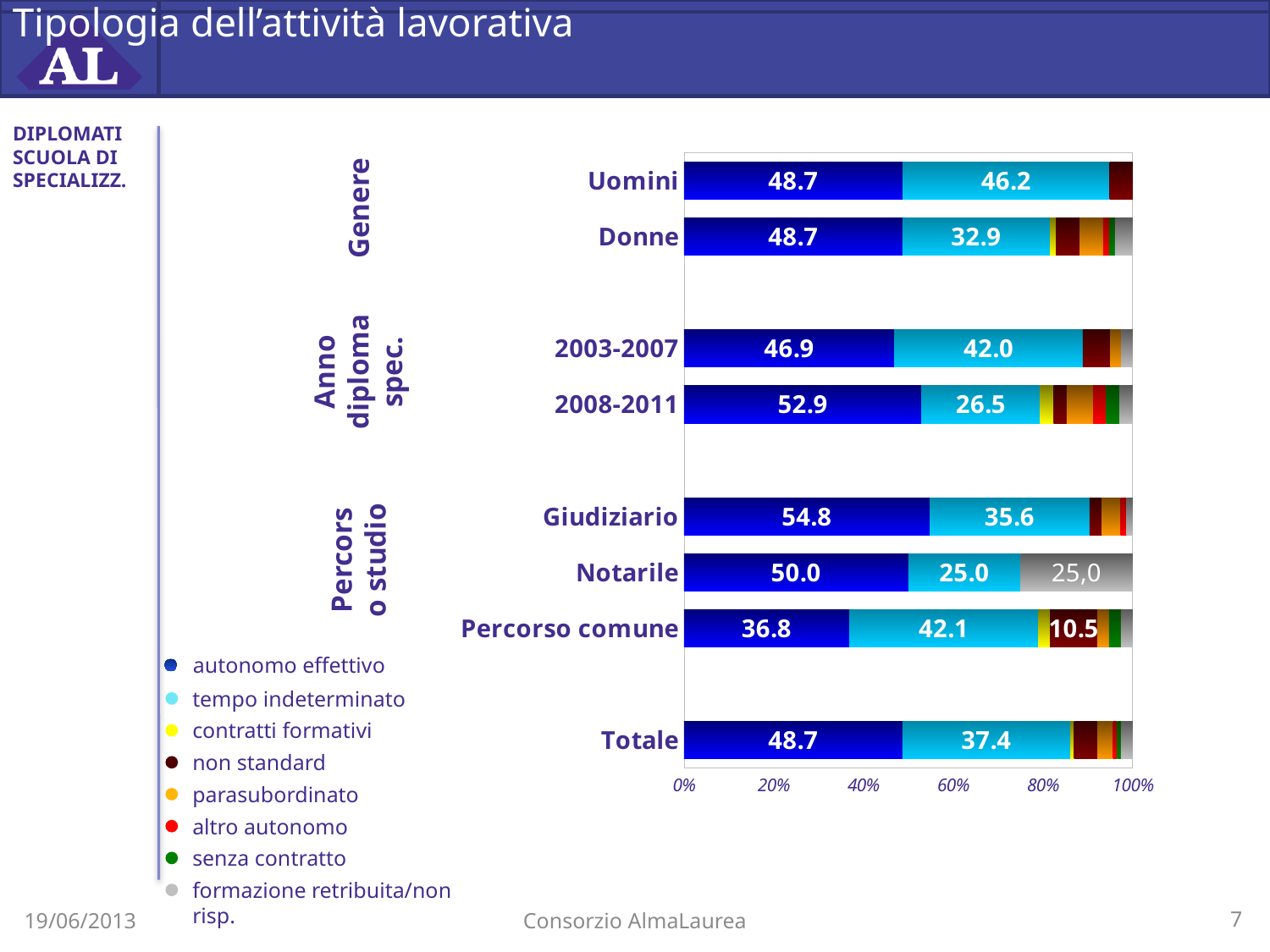
How many categories (bars) are plotted in the chart? 8 What is the value of 'tempo indeterminato' for Totale? 37.4 How many series does the legend list? 8 What is the value of 'tempo indeterminato' for 2008-2011? 26.5 Which is larger: the 'tempo indeterminato' value for 2003-2007 or for 2008-2011? 2003-2007 Which category has the lowest value for 'autonomo effettivo'? Percorso comune What kind of chart is shown on the slide? stacked bar chart What is the difference between the 'tempo indeterminato' values for Uomini and Donne? 13.3 Which legend entry is shown in grey? formazione retribuita/non risp. What is the value of 'autonomo effettivo' for Giudiziario? 54.8 Which category has the highest value for 'autonomo effettivo'? Giudiziario What is the value of 'non standard' for Percorso comune? 10.5